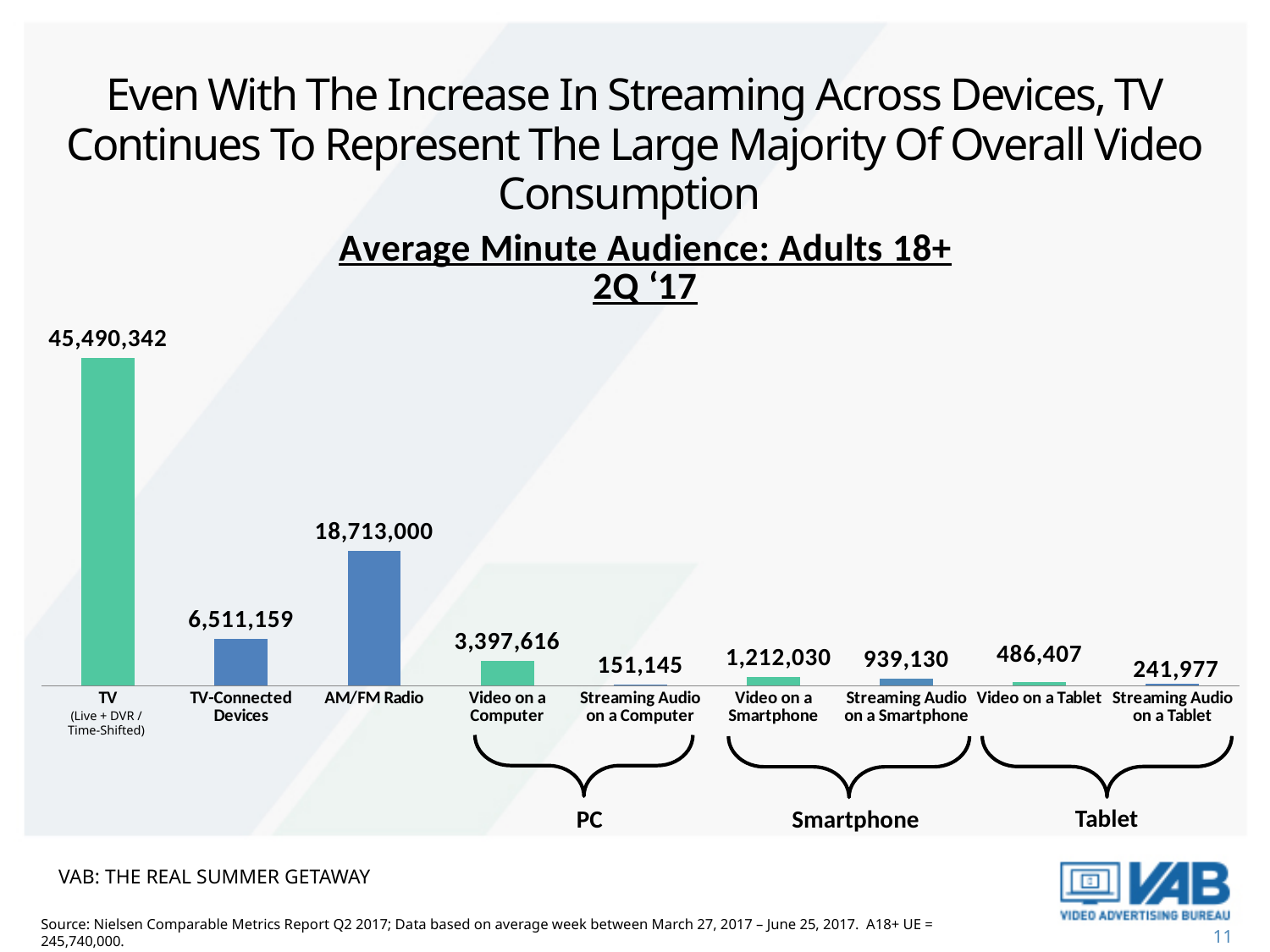
What is the average minute audience for TV (Live + DVR / Time-Shifted)? 45,490,342 What kind of chart is shown on the slide? Bar chart What is the difference between Video on a Smartphone and Streaming Audio on a Smartphone? 272,900 Which category has the highest average minute audience? TV Which is larger, TV-Connected Devices or Video on a Computer? TV-Connected Devices What is the value shown for Streaming Audio on a Computer? 151,145 What is the value shown for Video on a Tablet? 486,407 Which category has the lowest average minute audience? Streaming Audio on a Computer What is the title of the chart? Average Minute Audience: Adults 18+ 2Q '17 What is the value shown for AM/FM Radio? 18,713,000 What is the difference between the values for TV and AM/FM Radio? 26,777,342 How many categories are plotted in the chart? 9